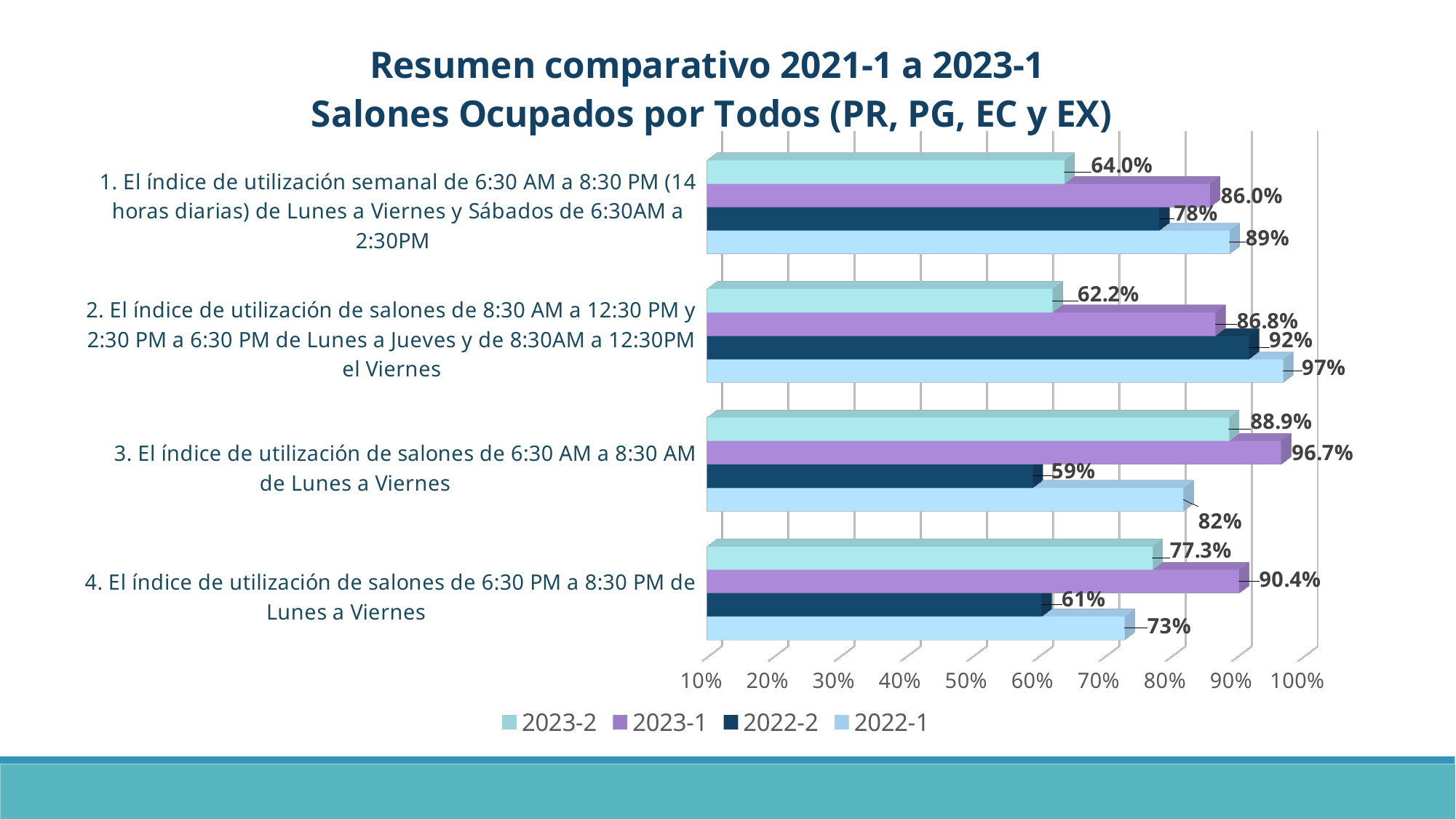
How many series does the legend list? 4 How many categories (índices de utilización) are plotted on the chart? 4 What is the 2023-1 value for category 3 (salones de 6:30 AM a 8:30 AM de Lunes a Viernes)? 96.7% For category 4 (salones de 6:30 PM a 8:30 PM), which is larger: the 2022-2 value or the 2022-1 value? 2022-1 What is the difference between the 2023-1 and 2023-2 values for category 1 (índice de utilización semanal)? 22.0% What is the 2023-2 value for category 4 (salones de 6:30 PM a 8:30 PM de Lunes a Viernes)? 77.3% What kind of chart is shown on the slide? bar chart Which series is shown in purple in the legend? 2023-1 Which series has the highest value for category 2 (salones de 8:30 AM a 12:30 PM y 2:30 PM a 6:30 PM)? 2022-1 What is the 2022-1 value for category 2 (salones de 8:30 AM a 12:30 PM y 2:30 PM a 6:30 PM)? 97% Which series has the lowest value for category 3 (salones de 6:30 AM a 8:30 AM de Lunes a Viernes)? 2022-2 What is the 2022-2 value for category 1 (índice de utilización semanal de 6:30 AM a 8:30 PM)? 78%